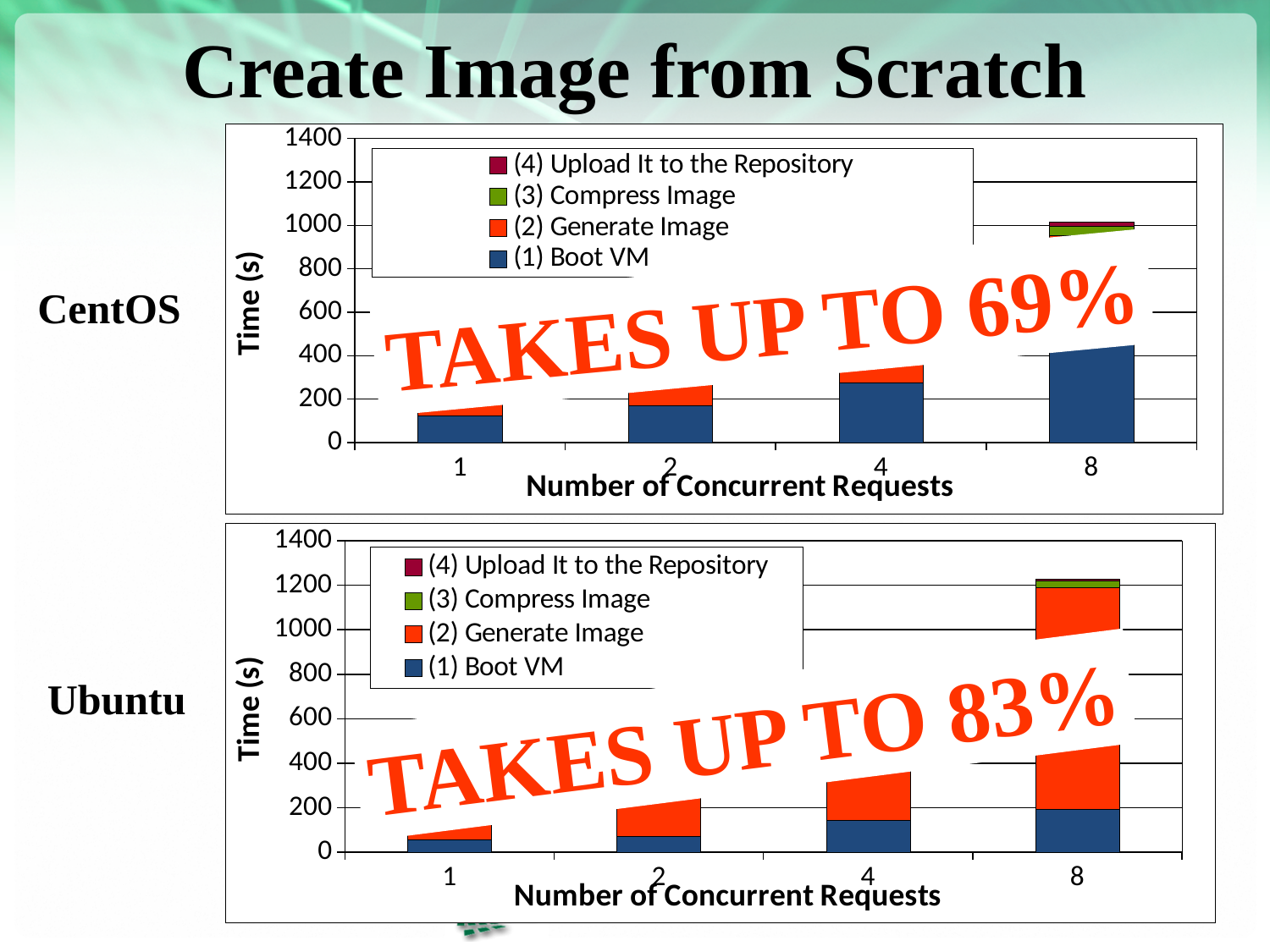
In the Ubuntu chart, which number of concurrent requests has the tallest total bar? 8 In the CentOS chart, is the (1) Boot VM time for 8 concurrent requests greater or less than 400? greater In the Ubuntu chart, which has the larger total time: 4 or 8 concurrent requests? 8 In the CentOS chart, what is the label of the y axis? Time (s) In the Ubuntu chart, do the total bar heights rise or fall as the number of concurrent requests increases? rise In the CentOS chart, which number of concurrent requests has the shortest total bar? 1 In the CentOS chart, what kind of chart is shown? stacked bar chart In the CentOS chart, how many series does the legend list? 4 In the Ubuntu chart, how many categories are shown on the x axis? 4 In the Ubuntu chart, what is the label of the x axis? Number of Concurrent Requests